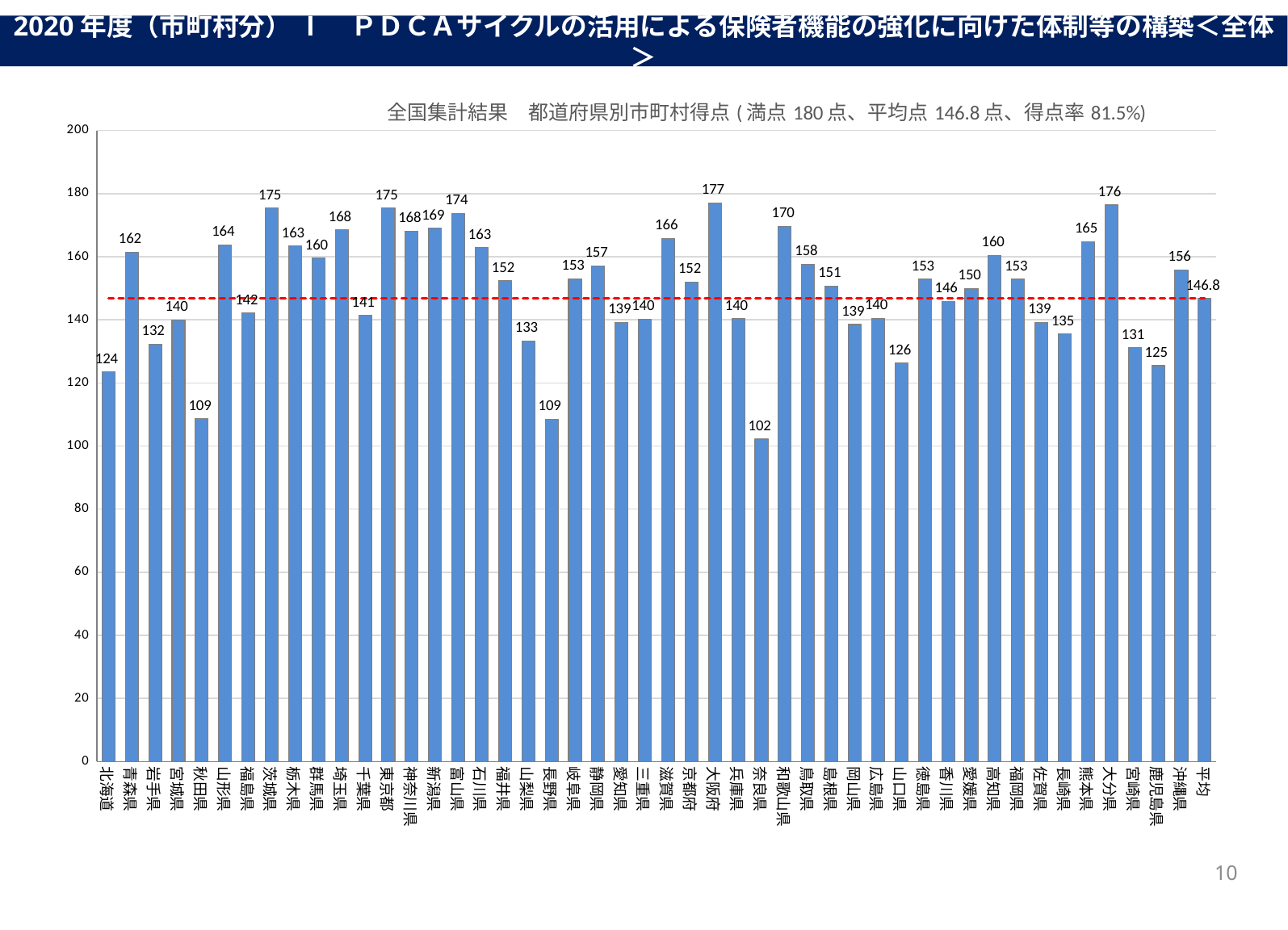
What kind of chart is shown on the slide? bar chart What value does the red dashed horizontal line represent, according to the chart title? 146.8 What is the value shown for 平均? 146.8 Which category has the highest value? 大阪府 How many bars are plotted in the chart, including 平均? 48 What is the difference between the values for 大分県 and 宮崎県? 45 Which is larger, the value for 茨城県 or the value for 千葉県? 茨城県 What is the value for 大阪府? 177 What is the value for 奈良県? 102 What is the difference between the values for 大阪府 and 奈良県? 75 Is the value for 秋田県 greater or less than 120? less Which category has the lowest value? 奈良県